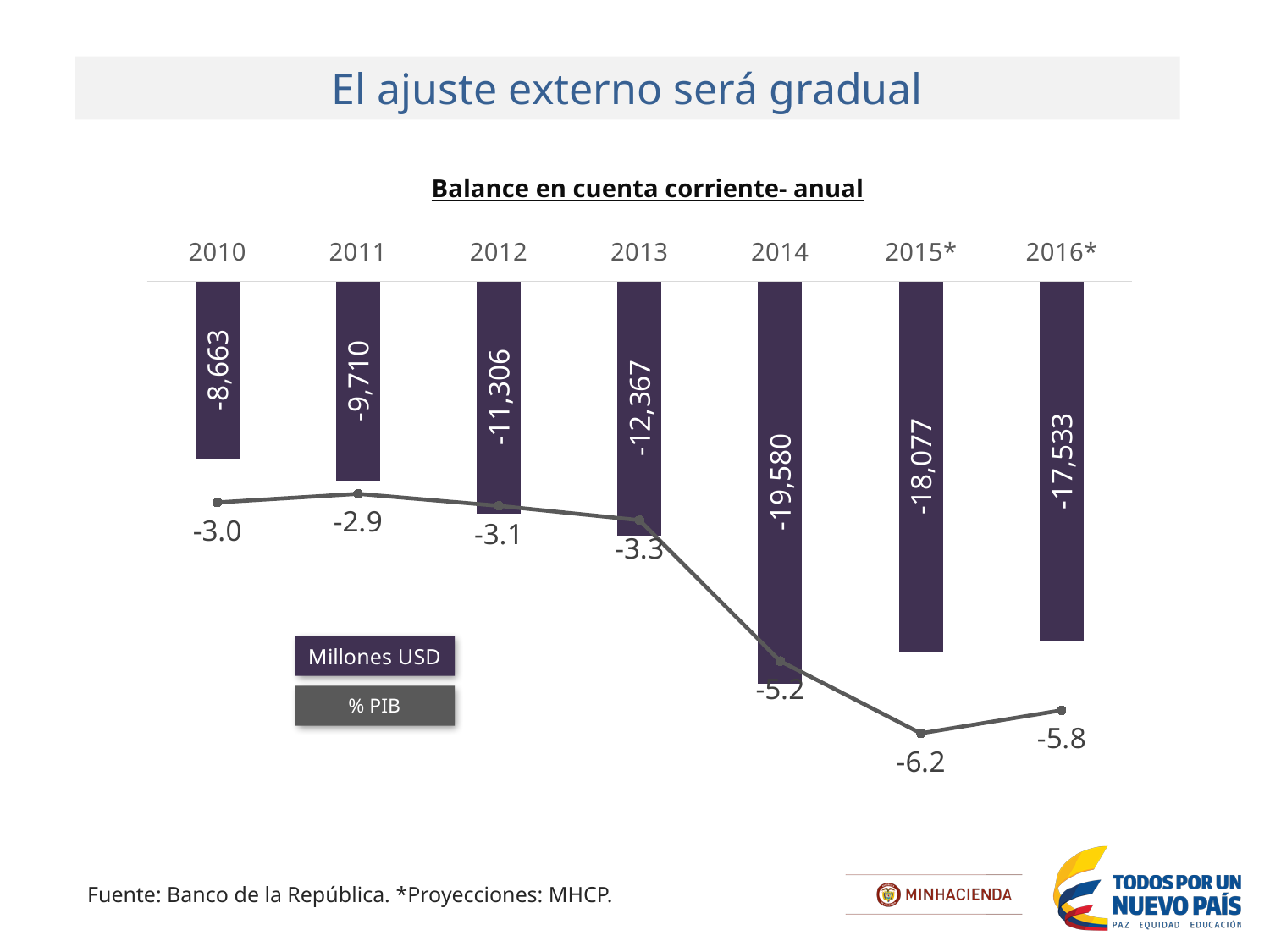
What is the difference between the Millones USD values for 2015* and 2016* in the 'Balance en cuenta corriente- anual' chart? 544 Which year has the highest (least negative) Millones USD value in the 'Balance en cuenta corriente- anual' chart? 2010 What is the Millones USD value for 2010 in the 'Balance en cuenta corriente- anual' chart? -8,663 How many series does the legend of the 'Balance en cuenta corriente- anual' chart list? 2 What is the Millones USD value for 2014 in the 'Balance en cuenta corriente- anual' chart? -19,580 What is the % PIB value for 2011 in the 'Balance en cuenta corriente- anual' chart? -2.9 Which year has the lowest (most negative) % PIB value in the 'Balance en cuenta corriente- anual' chart? 2015* Which is more negative in the 'Balance en cuenta corriente- anual' chart, the Millones USD value for 2012 or for 2013? 2013 How many years are shown on the x axis of the 'Balance en cuenta corriente- anual' chart? 7 What is the % PIB value for 2015* in the 'Balance en cuenta corriente- anual' chart? -6.2 Which series in the 'Balance en cuenta corriente- anual' chart is plotted as a line? % PIB Which year has the lowest (most negative) Millones USD value in the 'Balance en cuenta corriente- anual' chart? 2014